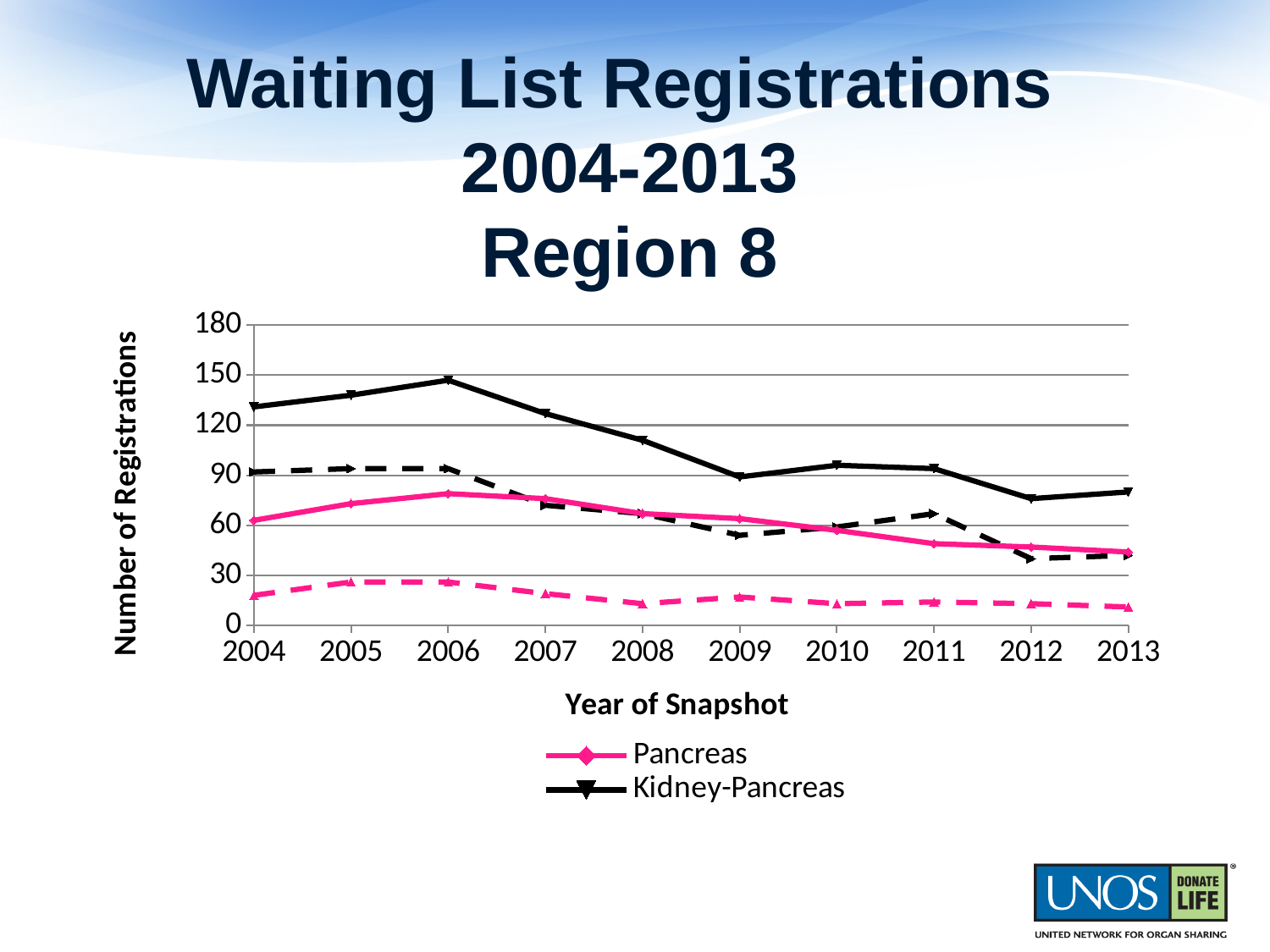
In 2004, which series has the larger value, Pancreas or Kidney-Pancreas? Kidney-Pancreas In which year does the Kidney-Pancreas line reach its highest value? 2006 Is the Kidney-Pancreas value for 2006 greater or less than 120? greater What kind of chart is shown on the slide? Line chart Does the Kidney-Pancreas line rise or fall between 2006 and 2009? Fall What is the title of the y axis? Number of Registrations Is the Pancreas value for 2013 greater or less than 60? less What is the title of the x axis? Year of Snapshot How many series does the chart legend list? 2 Is the Kidney-Pancreas value for 2012 greater or less than 90? less How many years are shown along the x axis of the chart? 10